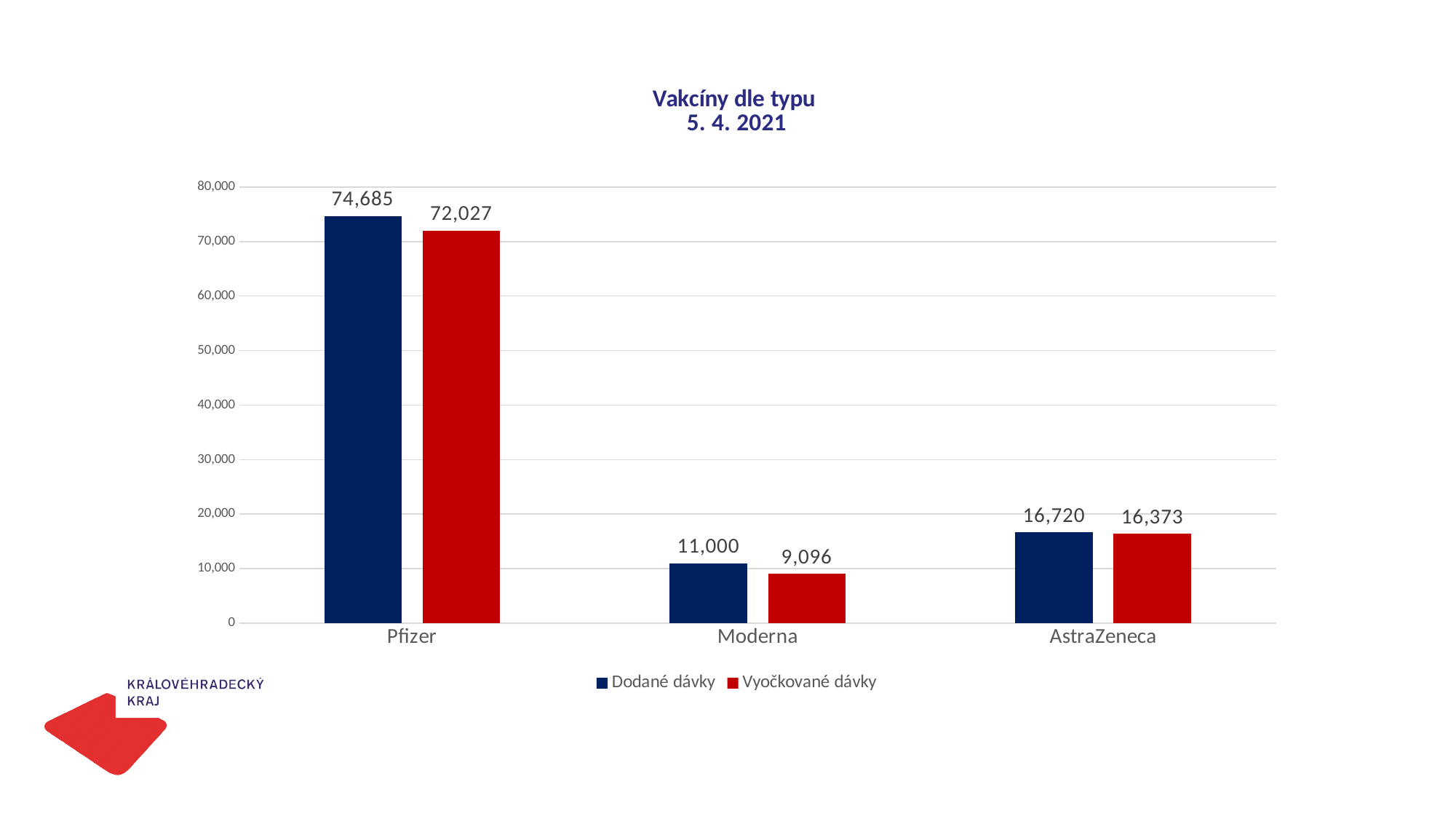
What is the difference between Dodané dávky and Vyočkované dávky for Moderna? 1,904 What is the difference between Dodané dávky and Vyočkované dávky for Pfizer? 2,658 How many series does the legend list? 2 Which vaccine type has the lowest Dodané dávky value? Moderna Which vaccine type has the highest Vyočkované dávky value? Pfizer What is the value of Dodané dávky for AstraZeneca? 16,720 How many vaccine types are shown on the x axis? 3 Which is larger: Dodané dávky for AstraZeneca or Dodané dávky for Moderna? Dodané dávky for AstraZeneca What is the title of the chart? Vakcíny dle typu 5. 4. 2021 What kind of chart is shown on the slide? Bar chart What is the value of Vyočkované dávky for Moderna? 9,096 What is the value of Dodané dávky for Pfizer? 74,685